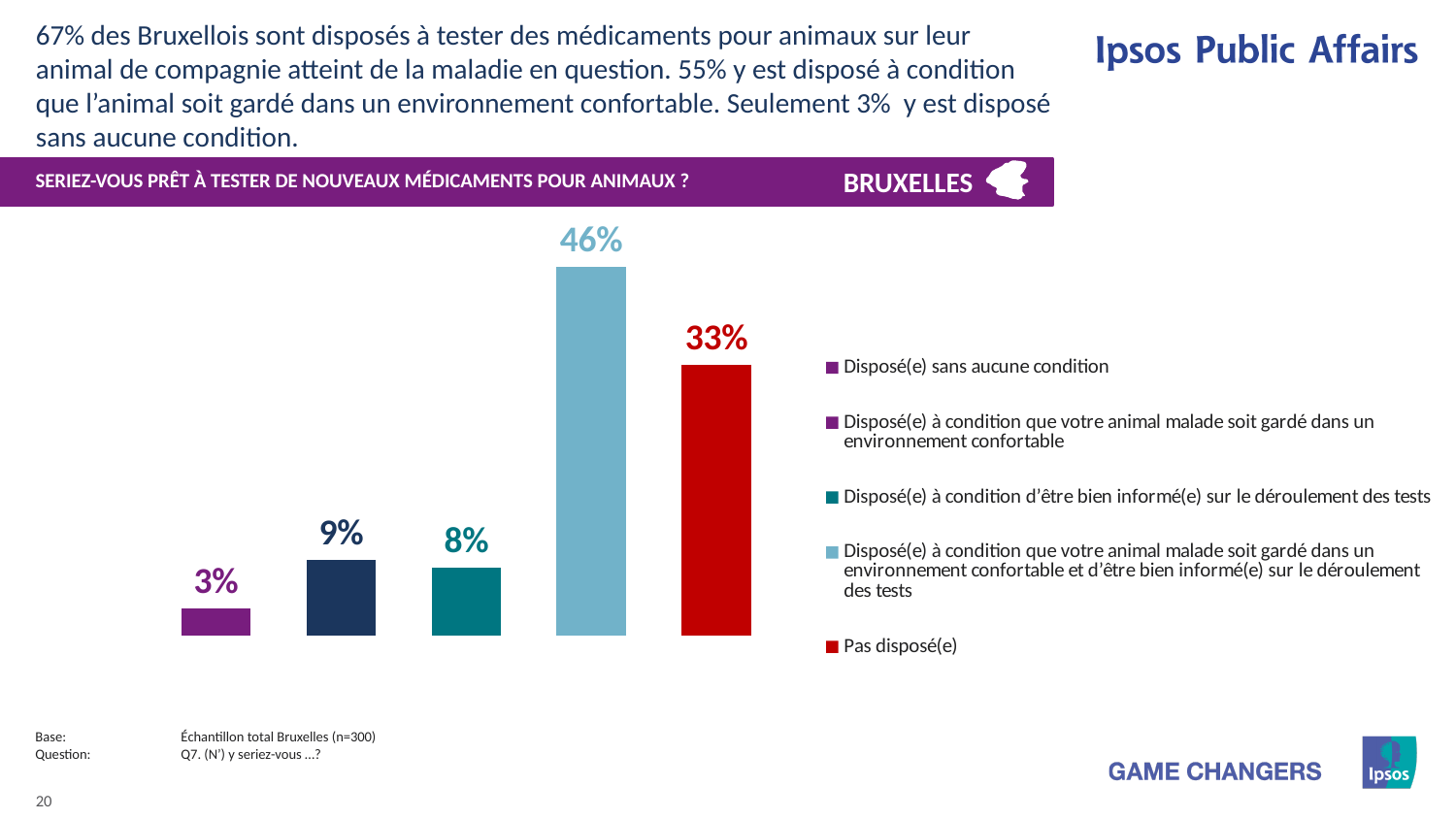
What is the value for "Disposé(e) sans aucune condition"? 3% What is the value for "Pas disposé(e)"? 33% Which legend category has the highest value? Disposé(e) à condition que votre animal malade soit gardé dans un environnement confortable et d'être bien informé(e) sur le déroulement des tests How many entries does the legend list? 5 Which is larger: the value for "Disposé(e) à condition que votre animal malade soit gardé dans un environnement confortable" or the value for "Disposé(e) à condition d'être bien informé(e) sur le déroulement des tests"? Disposé(e) à condition que votre animal malade soit gardé dans un environnement confortable What is the value for "Disposé(e) à condition d'être bien informé(e) sur le déroulement des tests"? 8% What kind of chart is shown on the slide? bar chart What is the difference between the value for "Pas disposé(e)" and the value for "Disposé(e) sans aucune condition"? 30% Which legend category has the lowest value? Disposé(e) sans aucune condition How many bars are plotted in the chart? 5 What colour is the bar for "Pas disposé(e)"? red What is the value for "Disposé(e) à condition que votre animal malade soit gardé dans un environnement confortable et d'être bien informé(e) sur le déroulement des tests"? 46%